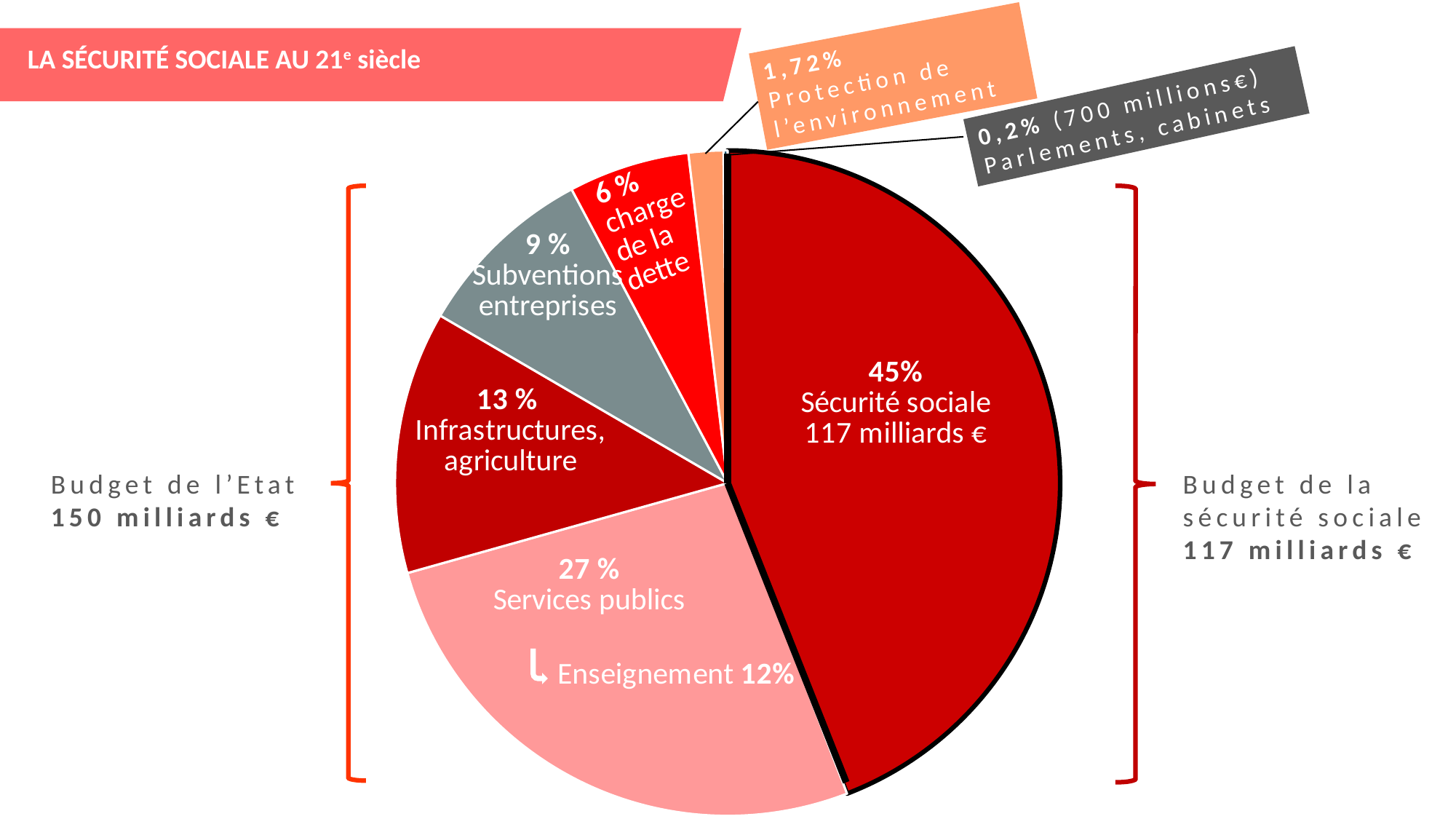
What percentage is shown for Protection de l'environnement? 1,72% What percentage is shown for Parlements, cabinets? 0,2% Which slice of the pie is the smallest? Parlements, cabinets What share of the pie does Sécurité sociale represent? 45% Which slice of the pie is the largest? Sécurité sociale How many slices does the pie chart have? 7 What percentage is shown for charge de la dette? 6 % What percentage is shown for Infrastructures, agriculture? 13 % What percentage is shown for Subventions entreprises? 9 % What is the difference in percentage points between Services publics and Infrastructures, agriculture? 14 What percentage is shown for Services publics? 27 % What kind of chart is shown on the slide? pie chart